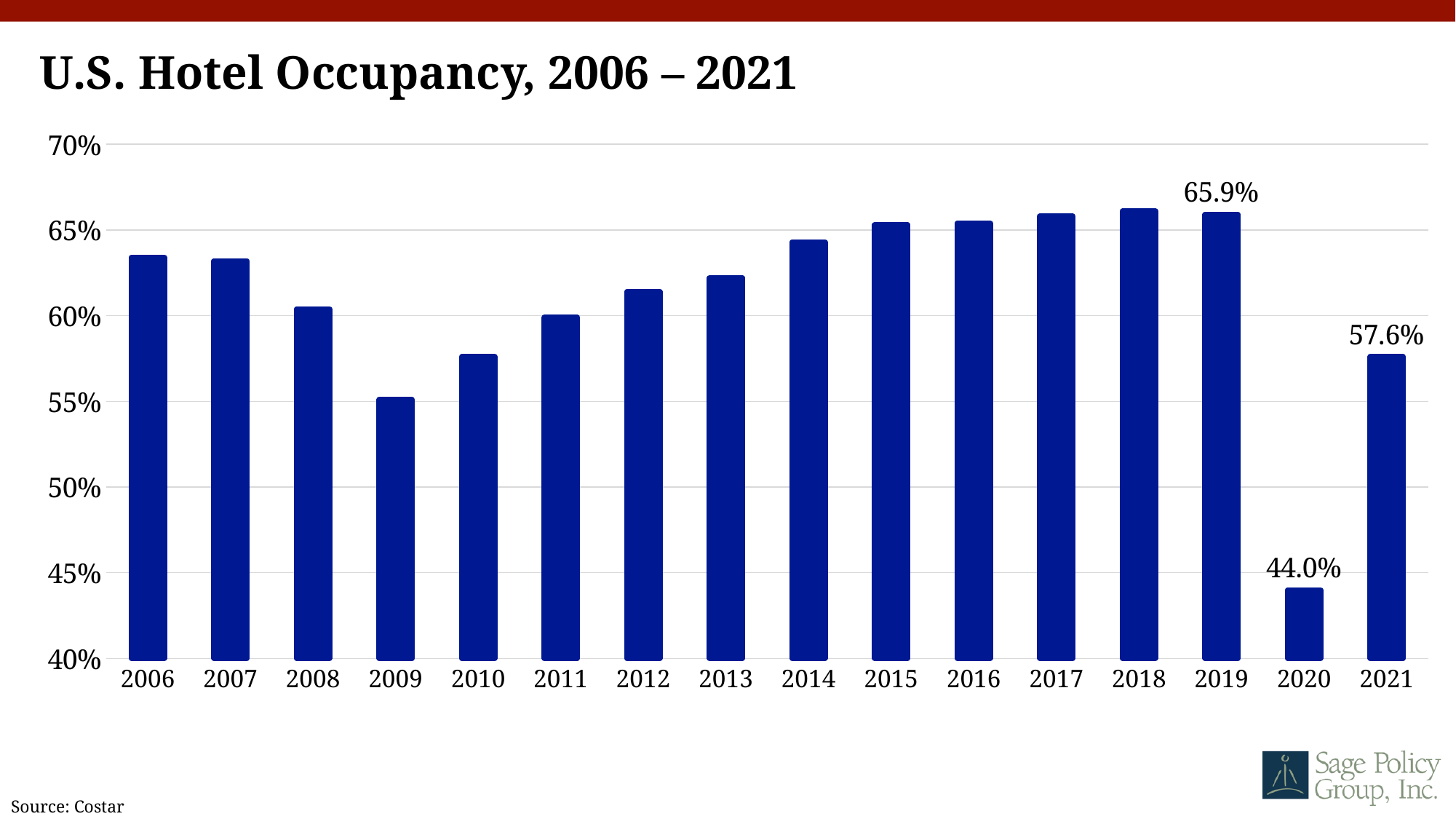
Which year had the lowest hotel occupancy rate? 2020 Did hotel occupancy rise or fall from 2009 to 2018? Rise What was the U.S. hotel occupancy rate in 2020? 44.0% By how many percentage points did hotel occupancy fall from 2019 to 2020? 21.9 percentage points By how many percentage points did hotel occupancy rise from 2020 to 2021? 13.6 percentage points How many years are shown on the chart? 16 What was the U.S. hotel occupancy rate in 2019? 65.9% Is the hotel occupancy value for 2014 greater or less than 65%? less What was the U.S. hotel occupancy rate in 2021? 57.6% What type of chart is used to show U.S. hotel occupancy? Bar chart Which year had higher hotel occupancy, 2006 or 2009? 2006 Is the hotel occupancy value for 2009 greater or less than 60%? less